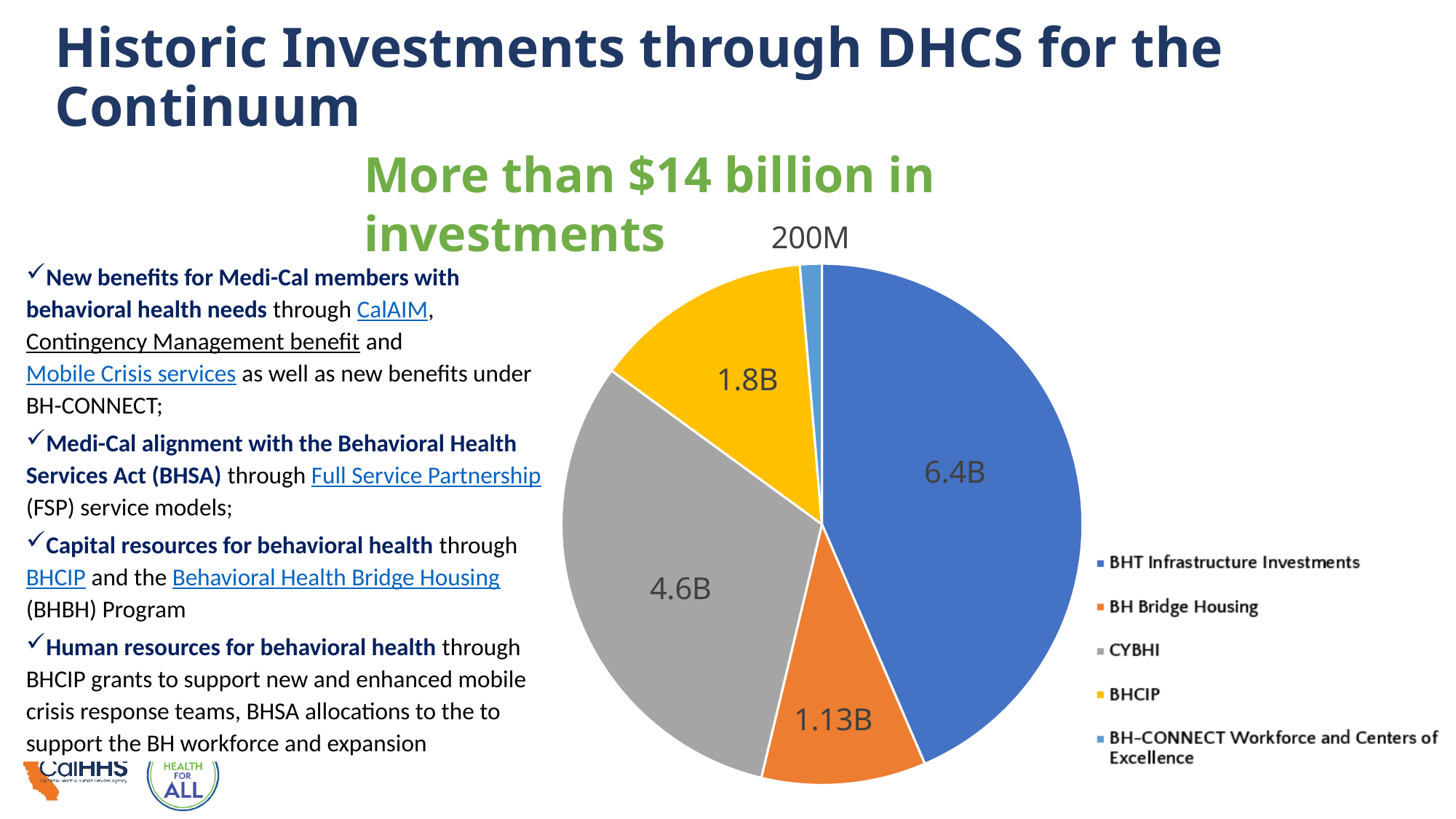
What is the value for BHT Infrastructure Investments? 6.4B How many categories does the pie chart show? 5 What is the value for BH Bridge Housing? 1.13B What is the value for BH-CONNECT Workforce and Centers of Excellence? 200M Which category has the smallest slice of the pie? BH-CONNECT Workforce and Centers of Excellence What is the value for BHCIP? 1.8B What is the difference between the values for BHT Infrastructure Investments and CYBHI? 1.8B What colour is the CYBHI slice? gray What type of chart is shown on the slide? pie chart What is the value for CYBHI? 4.6B Which category has the largest slice of the pie? BHT Infrastructure Investments Which is larger, the value for BHCIP or the value for BH Bridge Housing? BHCIP